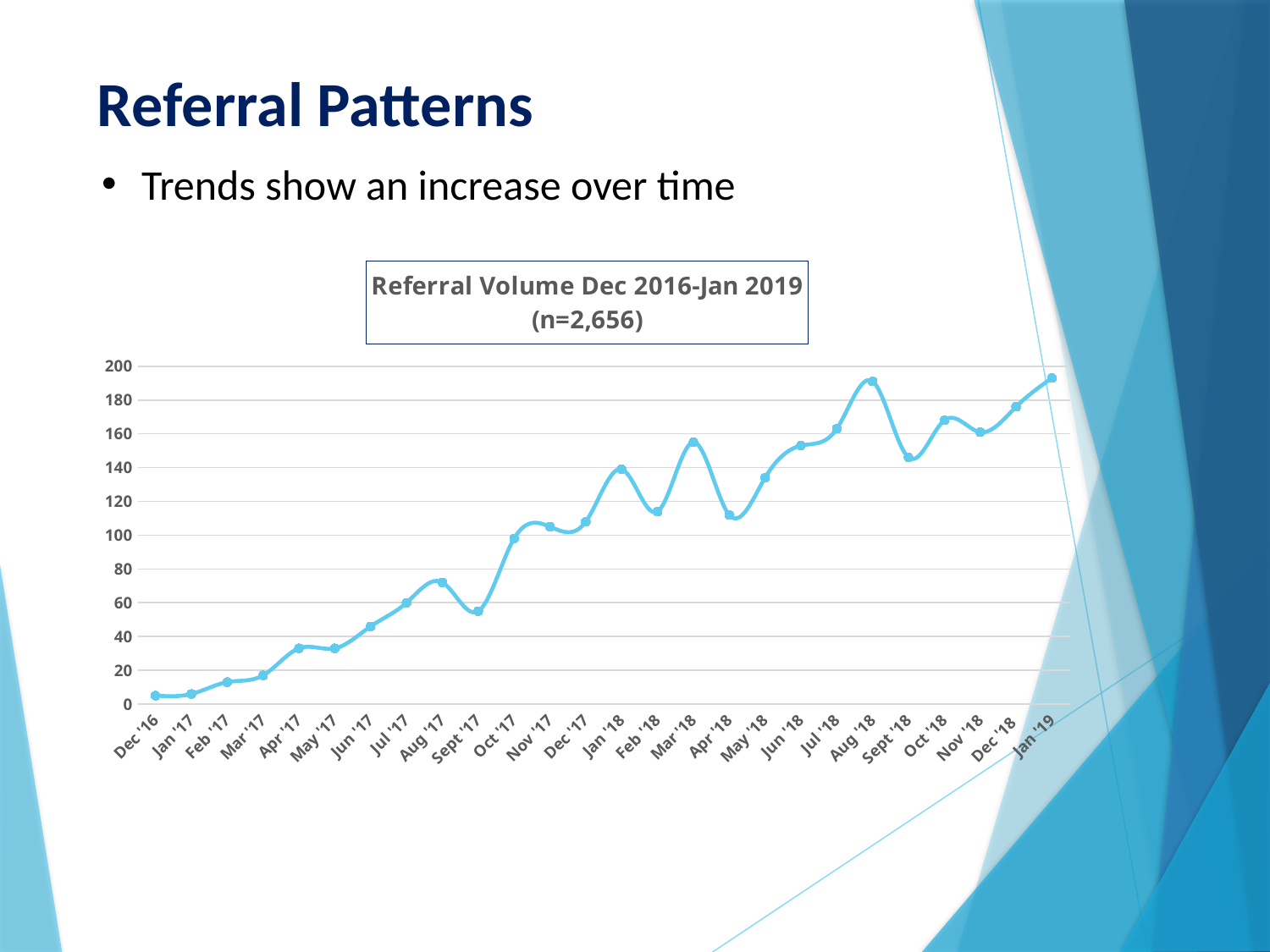
What kind of chart is shown on the slide? line chart What is the title of the chart? Referral Volume Dec 2016-Jan 2019 (n=2,656) Is the value for Jan '18 greater or less than 120? greater Do the referral volumes generally rise or fall from Dec '16 to Jan '19? rise Is the value for Sept '17 greater or less than 60? less Is the value for Dec '16 greater or less than 20? less Which month has the larger value, Mar '18 or Apr '18? Mar '18 Which month has the larger value, Jan '18 or Feb '18? Jan '18 What is the total sample size (n) stated in the chart title? 2,656 How many monthly data points are plotted on the chart? 26